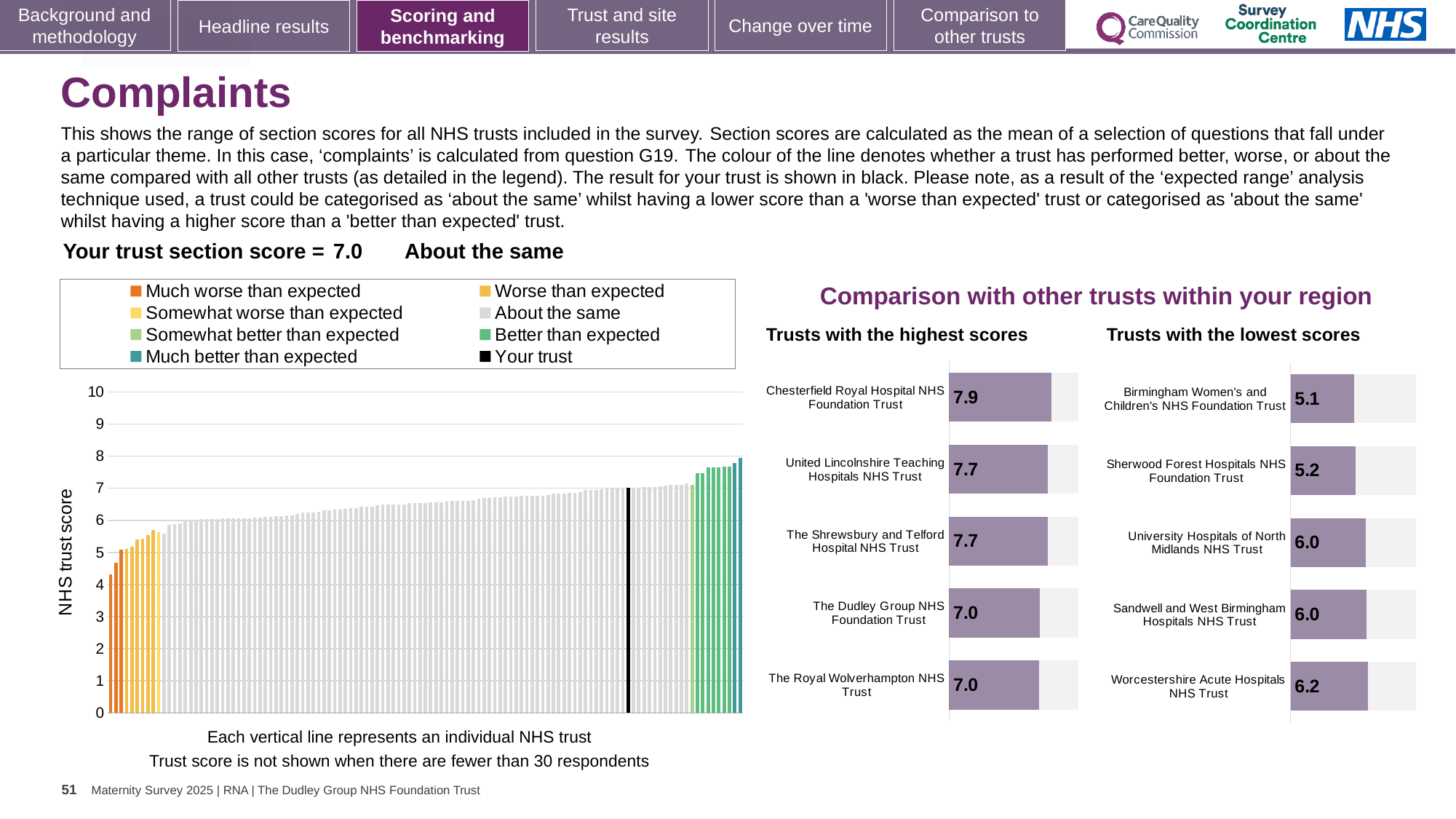
How many trusts are listed in the 'Trusts with the lowest scores' chart? 5 How many entries does the legend of the large 'NHS trust score' chart list? 8 In the 'Trusts with the highest scores' chart, what is the score for The Dudley Group NHS Foundation Trust? 7.0 In the 'Trusts with the lowest scores' chart, which trust has the lowest score? Birmingham Women's and Children's NHS Foundation Trust In the 'Trusts with the highest scores' chart, what is the score for Chesterfield Royal Hospital NHS Foundation Trust? 7.9 What kind of chart is the large 'NHS trust score' chart on the left? Bar chart In the large 'NHS trust score' chart on the left, do the values rise or fall from left to right? Rise In the 'Trusts with the highest scores' chart, what is the difference between the scores of Chesterfield Royal Hospital NHS Foundation Trust and The Royal Wolverhampton NHS Trust? 0.9 In the 'Trusts with the highest scores' chart, which trust has the highest score? Chesterfield Royal Hospital NHS Foundation Trust In the 'Trusts with the lowest scores' chart, what is the score for Worcestershire Acute Hospitals NHS Trust? 6.2 In the 'Trusts with the lowest scores' chart, which has the larger score: Sherwood Forest Hospitals NHS Foundation Trust or University Hospitals of North Midlands NHS Trust? University Hospitals of North Midlands NHS Trust In the 'Trusts with the lowest scores' chart, what is the difference between the scores of Worcestershire Acute Hospitals NHS Trust and Birmingham Women's and Children's NHS Foundation Trust? 1.1